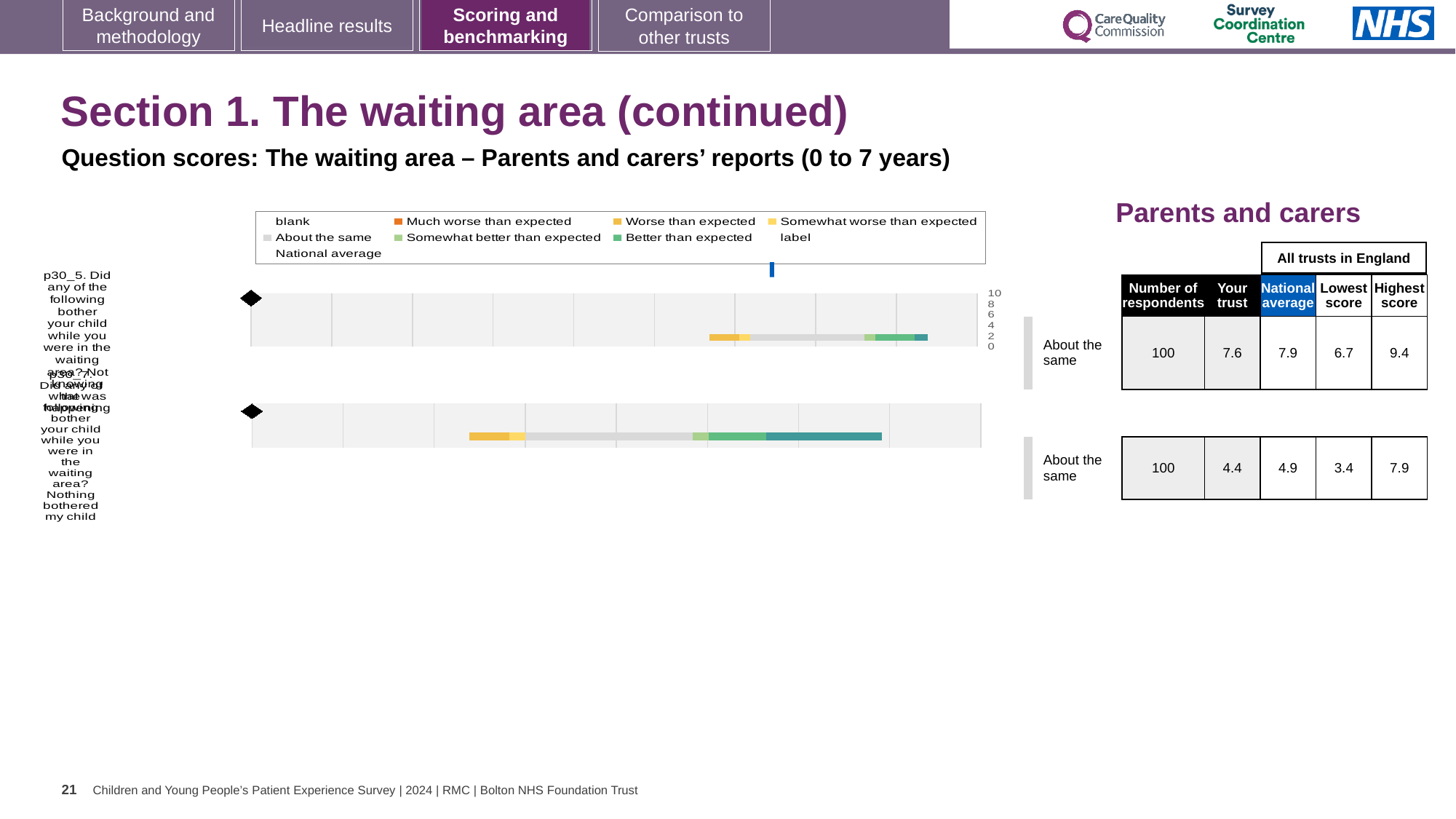
How many questions (bars) are plotted in the chart? 2 What is the difference between the highest score and the lowest score for the top question (p30_5)? 2.7 What benchmark category is the trust placed in for both questions? About the same What is the maximum value shown on the chart's score axis? 10 How many respondents are reported for the bottom question (p30_7)? 100 How many entries does the chart legend list? 9 For the top question (p30_5), which is larger: the trust's score or the national average? National average What is the 'Your trust' score for the top question (p30_5)? 7.6 What kind of chart is shown on the slide? Bar chart What is the difference between the national average and the trust's score for the bottom question (p30_7)? 0.5 What is the national average score for the top question (p30_5)? 7.9 What is the lowest score across all trusts in England for the bottom question (p30_7)? 3.4